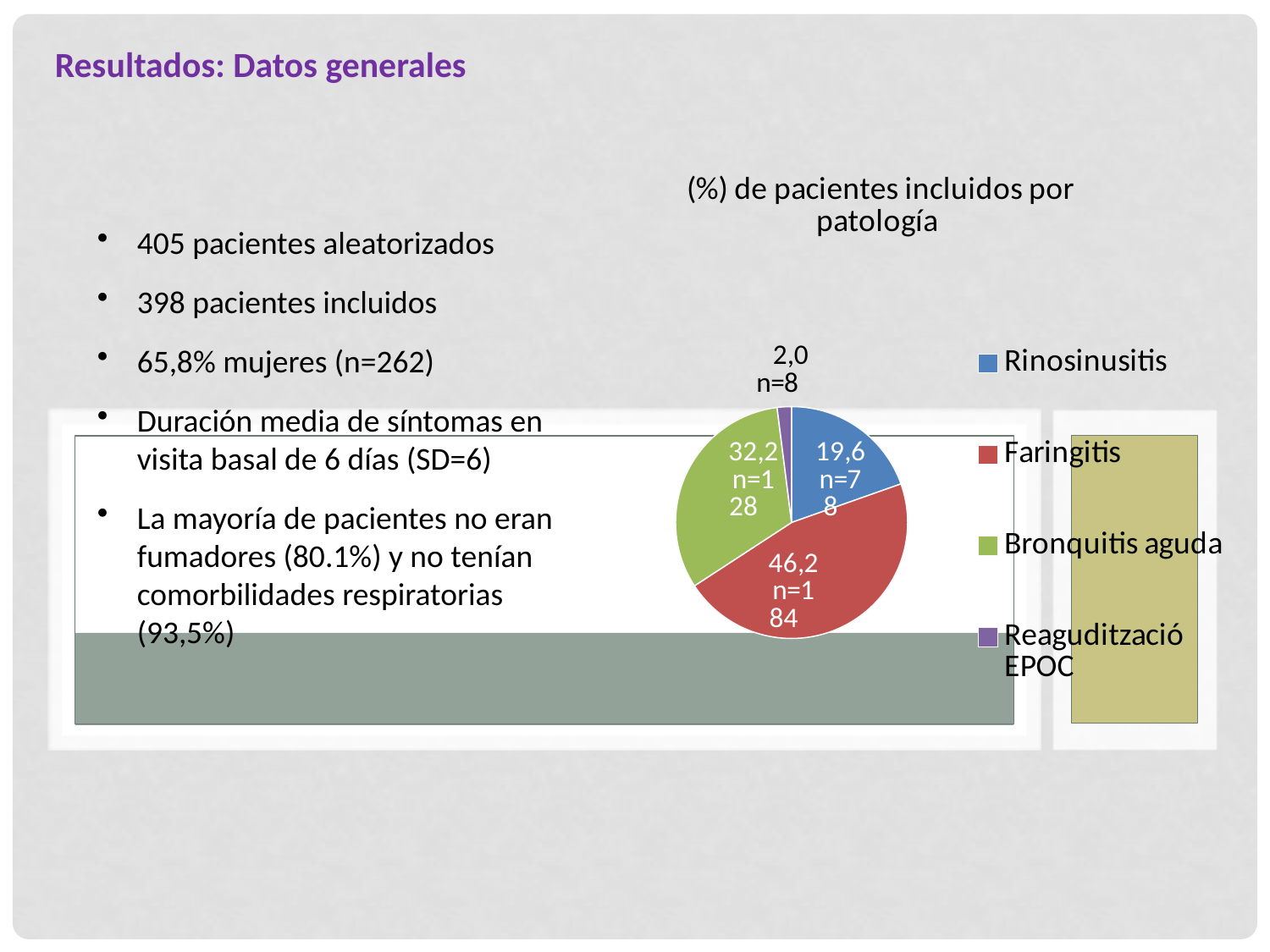
What is the title of the chart? (%) de pacientes incluidos por patología What percentage of patients is shown for Bronquitis aguda? 32,2 How many patients (n) are in the Reagudització EPOC slice? n=8 Which pathology has the largest share of patients? Faringitis How many entries does the legend list? 4 What percentage of patients is shown for Faringitis? 46,2 What kind of chart is shown on the slide? pie chart What percentage of patients is shown for Rinosinusitis? 19,6 What is the difference in percentage points between Faringitis and Bronquitis aguda? 14,0 Which has a larger share, Bronquitis aguda or Rinosinusitis? Bronquitis aguda Which pathology has the smallest share of patients? Reagudització EPOC How many slices does the pie chart have? 4